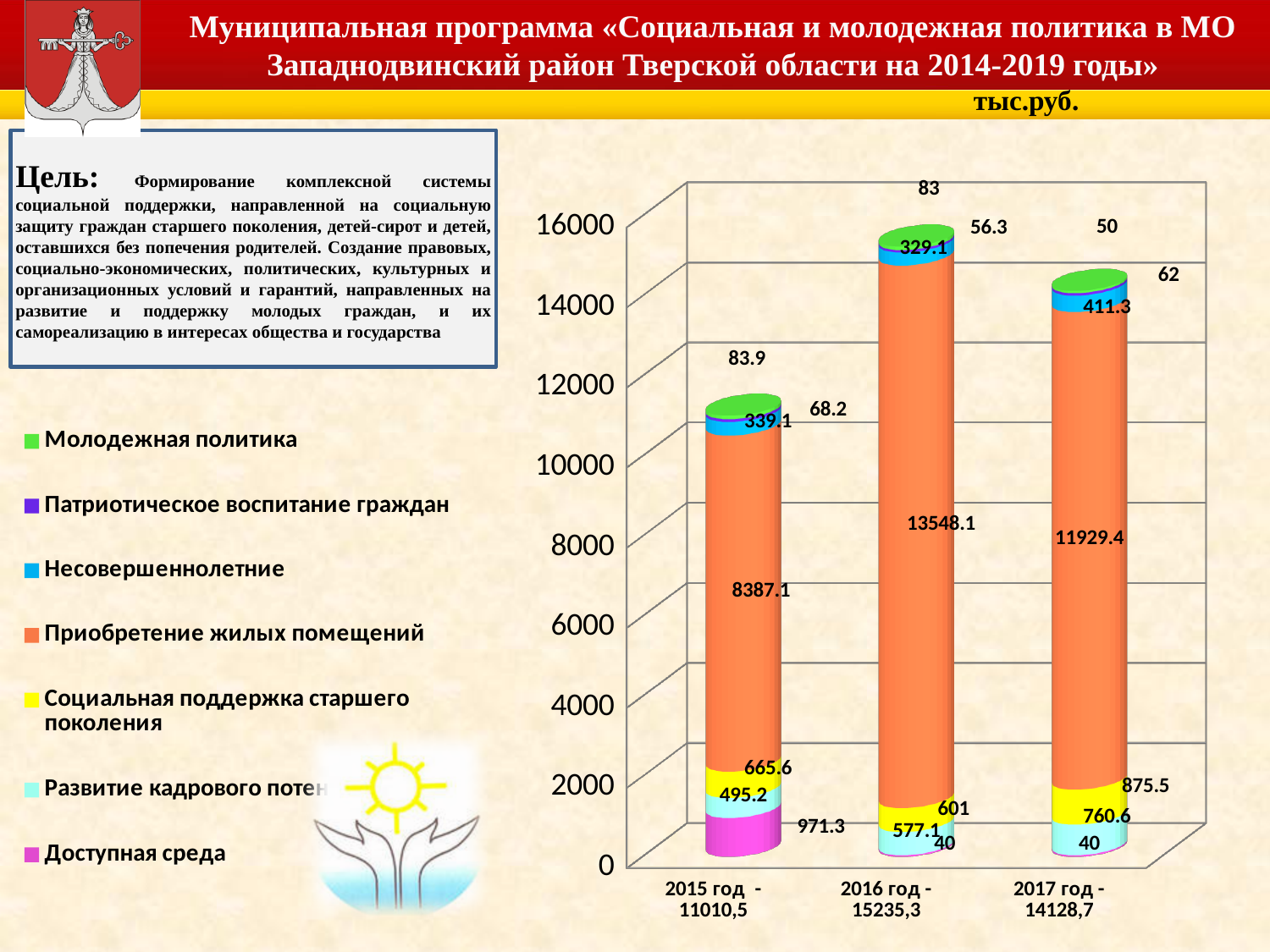
What kind of chart is shown on the slide? bar chart Is the total height of the 2016 stacked bar greater or less than 14000? greater In which year is the value for Приобретение жилых помещений the highest? 2016 How many series does the chart legend list? 7 How many years (categories) are plotted on the x axis of the chart? 3 What is the total of the stacked bar for 2015, as printed on the slide? 11010,5 What is the value for Доступная среда in 2015? 971.3 What colour represents Приобретение жилых помещений in the chart? orange What is the difference between the Приобретение жилых помещений values for 2016 and 2017? 1618.7 What is the value for Приобретение жилых помещений in 2016? 13548.1 Which year has the larger value for Социальная поддержка старшего поколения, 2015 or 2017? 2017 What is the value for Несовершеннолетние in 2017? 411.3